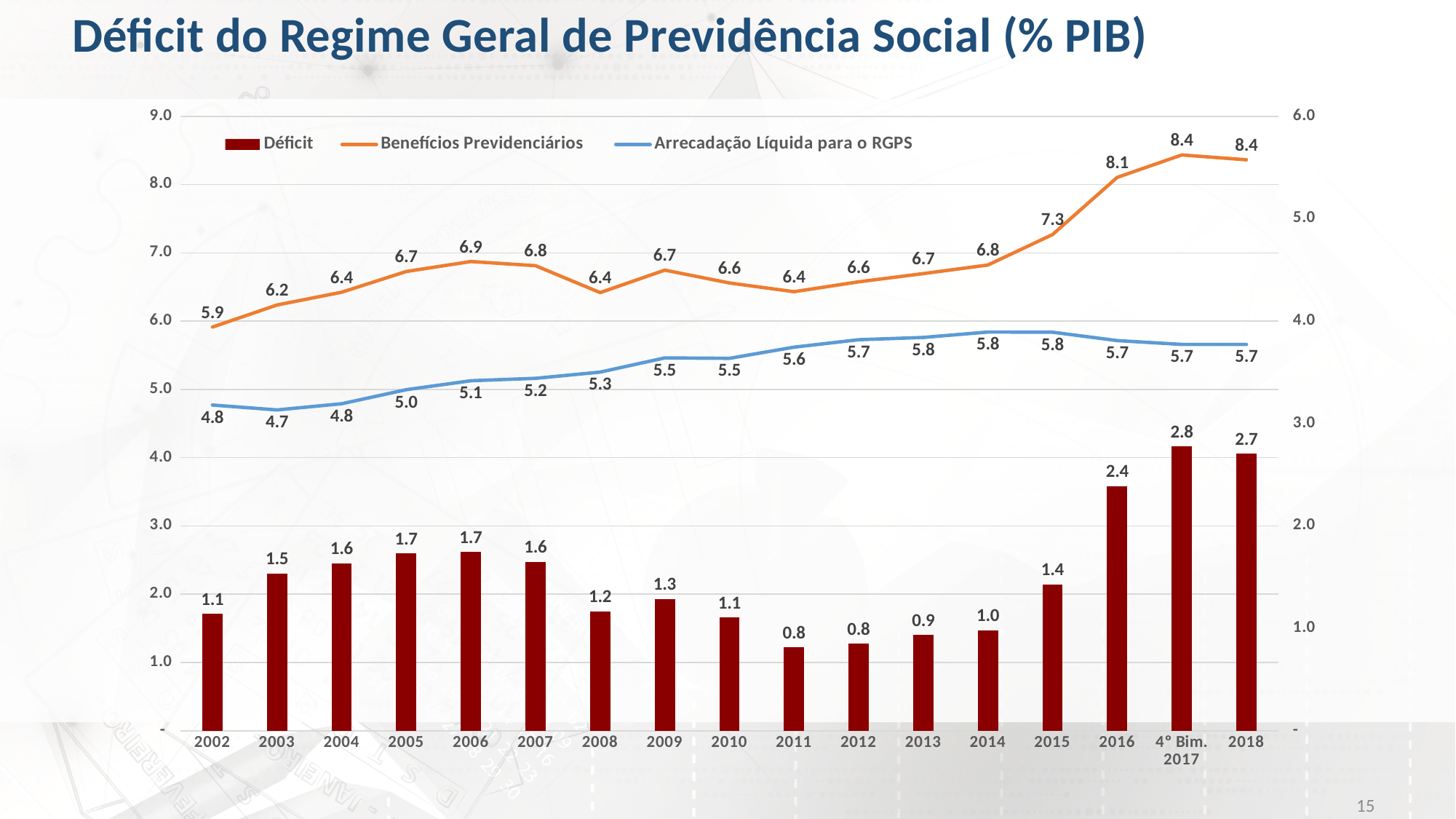
Is the Benefícios Previdenciários value for 2015 greater or less than 7.0? greater Which category has the highest Déficit value? 4° Bim. 2017 What is the Déficit value for 2016? 2.4 Which year has the lowest Arrecadação Líquida para o RGPS value? 2003 What is the difference between the Déficit in 2016 and the Déficit in 2015? 1.0 How many series does the legend list? 3 Which is larger, the Déficit in 2009 or the Déficit in 2016? 2016 What kind of chart is shown on the slide? Combination bar and line chart What is the Arrecadação Líquida para o RGPS value for 2010? 5.5 What is the Benefícios Previdenciários value for 2006? 6.9 What is the difference between Benefícios Previdenciários and Arrecadação Líquida para o RGPS in 2018? 2.7 How many categories are shown on the x axis? 17